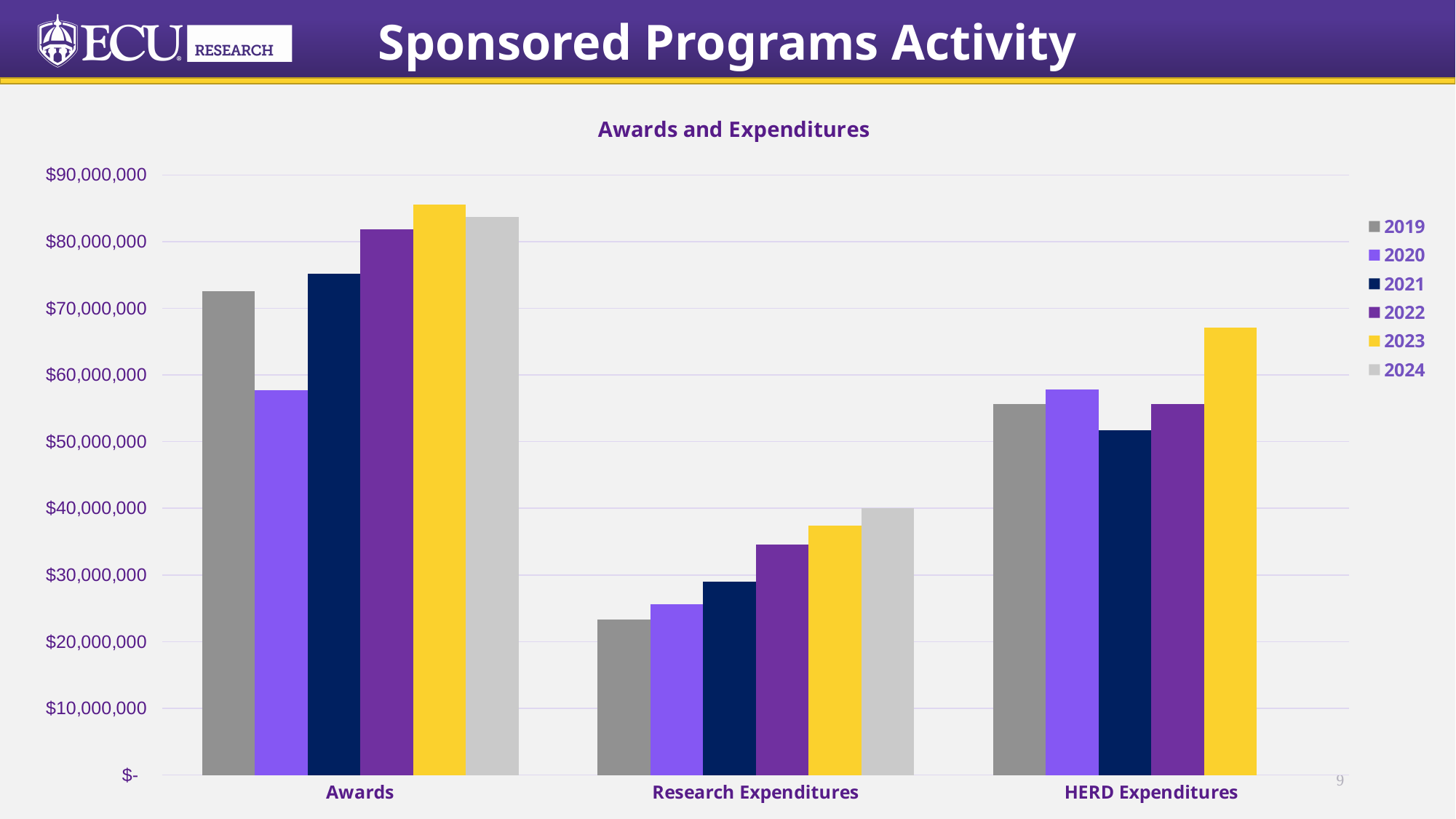
Which year has the highest value in the HERD Expenditures category? 2023 Do the Research Expenditures values rise or fall from 2019 to 2024? Rise Is the 2023 value for HERD Expenditures greater or less than $60,000,000? greater Which year has the highest value in the Awards category? 2023 How many series does the legend list? 6 Which year has the lowest value in the Awards category? 2020 Which year has the lowest value in the HERD Expenditures category? 2021 What is the title of the chart? Awards and Expenditures What kind of chart is shown on the slide? Bar chart How many categories are shown along the x axis? 3 Which is larger: the 2021 value for Awards or the 2023 value for HERD Expenditures? 2021 Awards Is the 2019 value for Awards greater or less than $70,000,000? greater